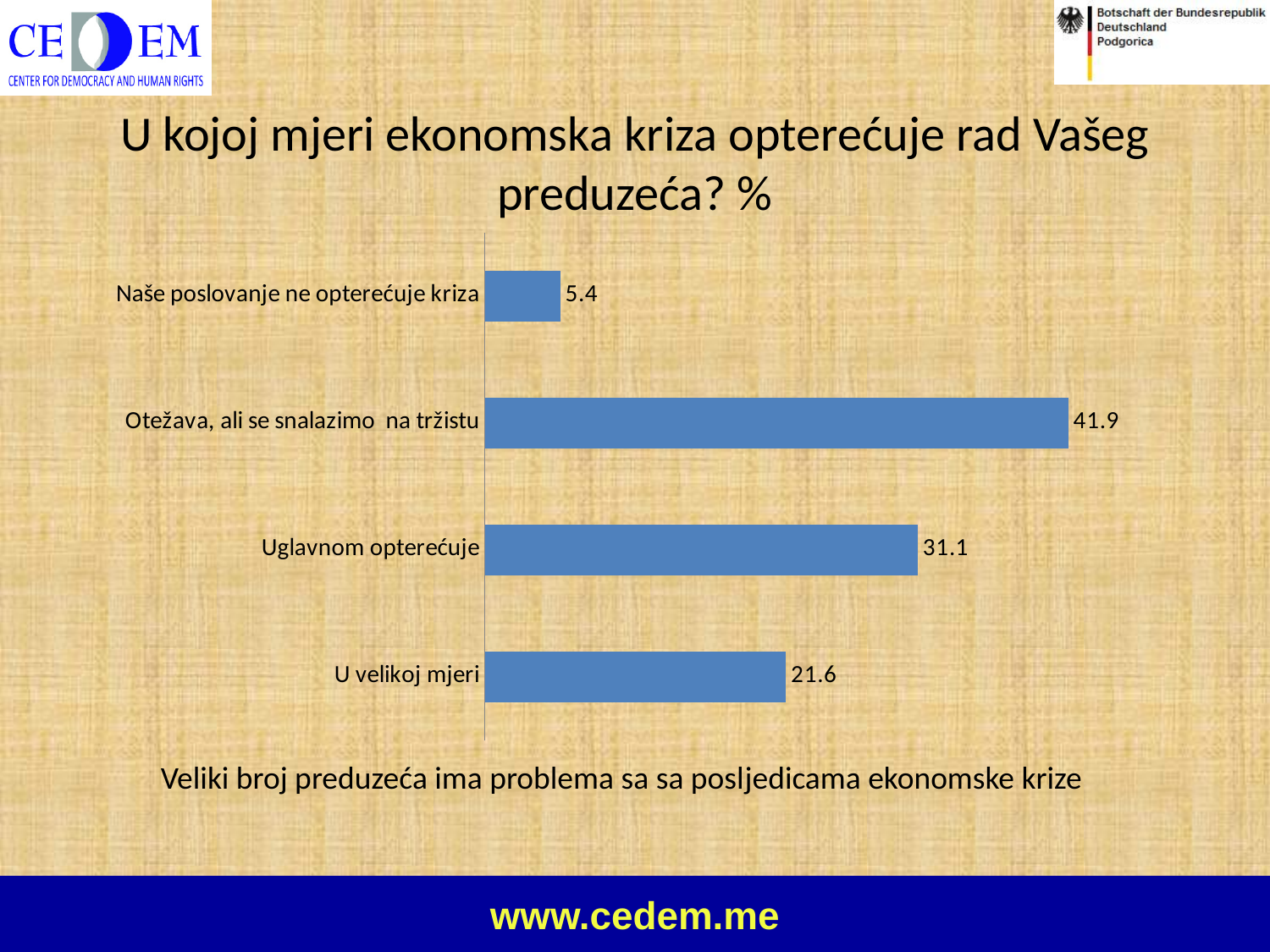
What is the difference between the values for "U velikoj mjeri" and "Naše poslovanje ne opterećuje kriza"? 16.2 What is the value for "Uglavnom opterećuje"? 31.1 What is the value for "U velikoj mjeri"? 21.6 What is the title of the chart? U kojoj mjeri ekonomska kriza opterećuje rad Vašeg preduzeća? % What is the value for "Otežava, ali se snalazimo na tržistu"? 41.9 How many categories are shown in the chart? 4 Which is larger, the value for "Uglavnom opterećuje" or the value for "U velikoj mjeri"? Uglavnom opterećuje Which category has the lowest value? Naše poslovanje ne opterećuje kriza What is the difference between the values for "Otežava, ali se snalazimo na tržistu" and "Uglavnom opterećuje"? 10.8 What is the value for "Naše poslovanje ne opterećuje kriza"? 5.4 Which category has the highest value? Otežava, ali se snalazimo na tržistu What kind of chart is shown on the slide? Bar chart